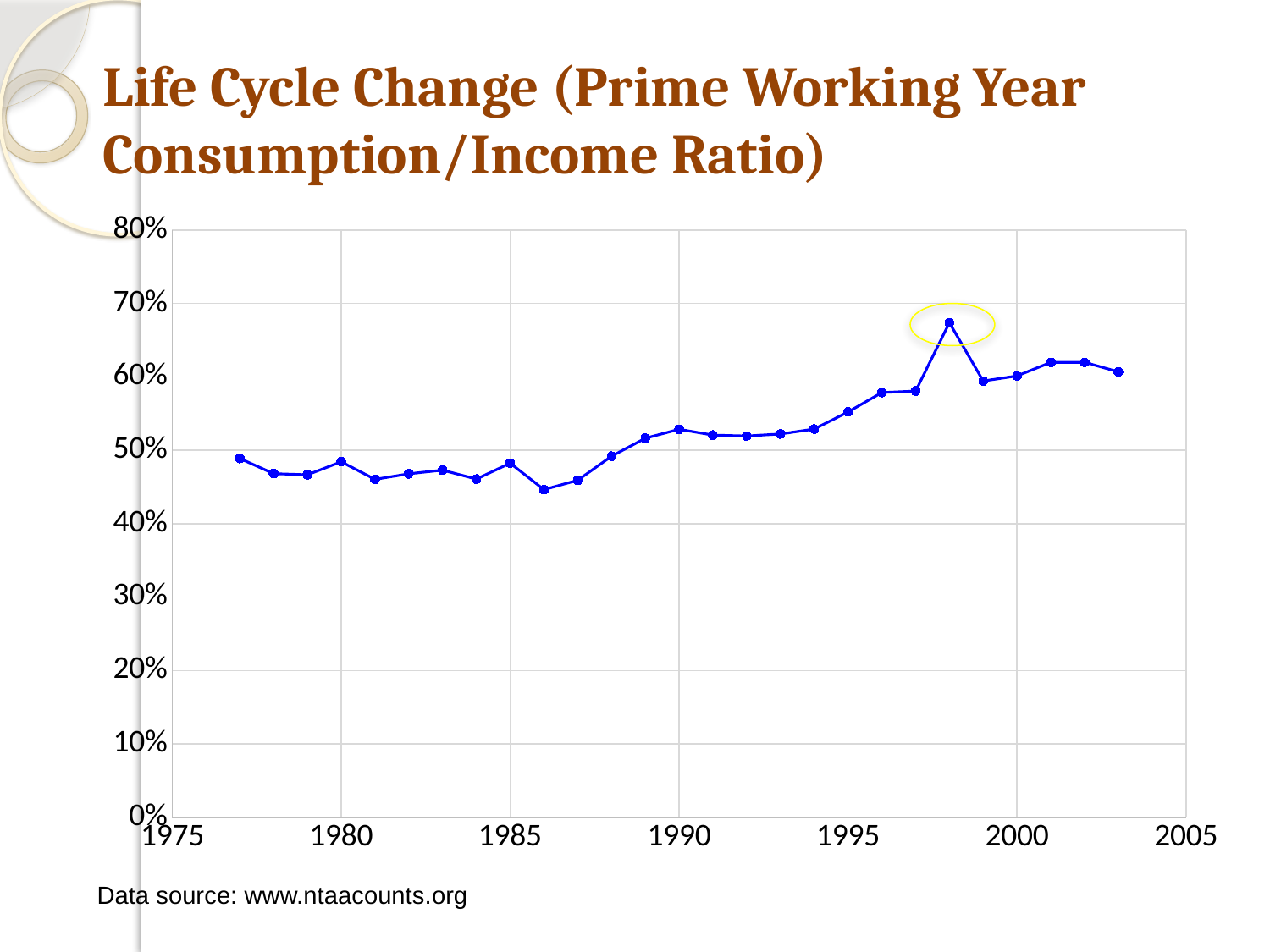
Overall, does the consumption/income ratio rise or fall from 1977 to 2003? Rise Is the value for 1990 greater or less than 50%? greater In which year does the consumption/income ratio reach its lowest value? 1986 Is the value for 1986 greater or less than 50%? less In which year does the consumption/income ratio reach its highest value? 1998 What kind of chart is shown on the slide? Line chart What is the title of the chart on the slide? Life Cycle Change (Prime Working Year Consumption/Income Ratio) Which data point on the chart is highlighted with a yellow circle? 1998 Is the value for 1977 greater or less than 50%? less Which year has the larger value, 1998 or 1977? 1998